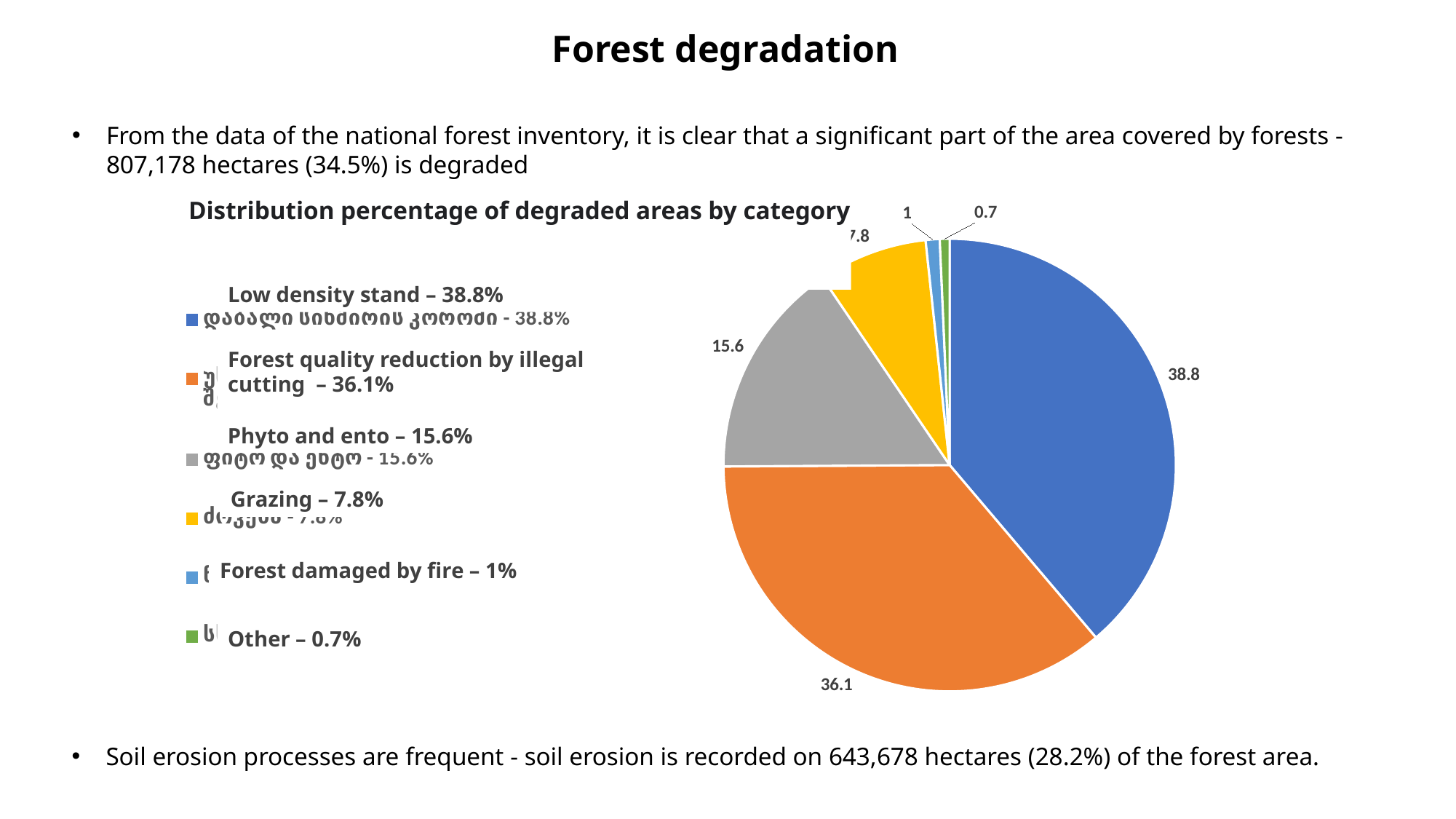
Which category has the largest share of the pie? Low density stand Which category has the smallest share of the pie? Other What is the value shown for the Forest damaged by fire slice? 1 What is the value shown for the Phyto and ento slice? 15.6 What is the difference between the Low density stand value and the Forest quality reduction by illegal cutting value? 2.7 What is the value shown for the Low density stand slice? 38.8 How many slices does the pie chart have? 6 What type of chart is shown on the slide? pie chart What is the title of the chart? Distribution percentage of degraded areas by category What is the value shown for the Grazing slice? 7.8 What is the value shown for the Forest quality reduction by illegal cutting slice? 36.1 Which is larger, the Phyto and ento slice or the Grazing slice? Phyto and ento